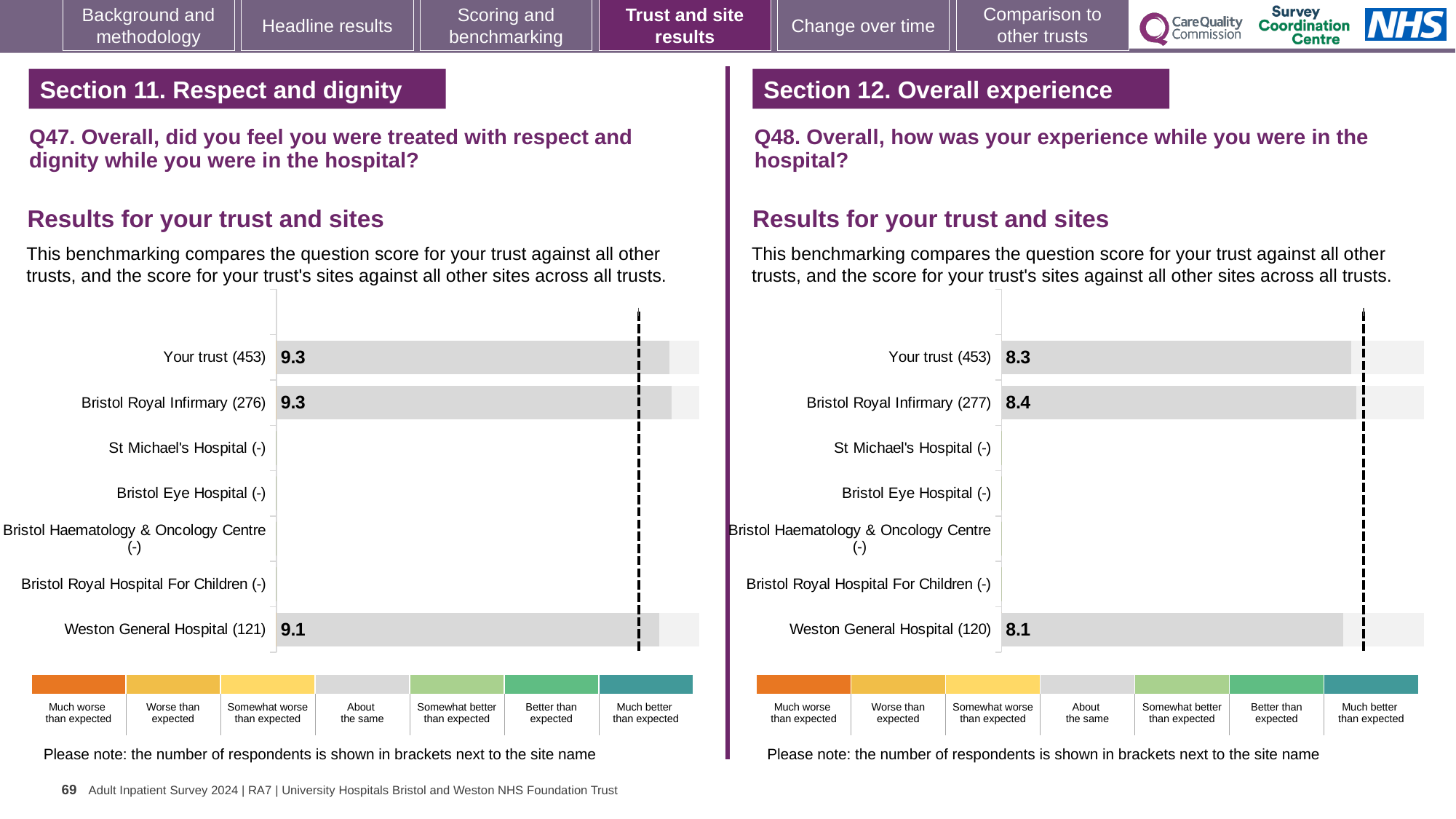
In the Q48 chart on the right, which is larger: the score for Your trust or the score for Weston General Hospital? Your trust In the Q48 chart on the right, what is the score for Weston General Hospital? 8.1 In the Q48 chart on the right, what is the score for Bristol Royal Infirmary? 8.4 What kind of chart is used for the Q47 results on the left? Bar chart In the Q48 chart on the right, which site or trust row has the highest score? Bristol Royal Infirmary In the Q47 chart on the left, what is the score for Weston General Hospital? 9.1 In the Q48 chart on the right, which site or trust row has the lowest score? Weston General Hospital In the Q48 chart on the right, what is the difference between the score for Bristol Royal Infirmary and the score for Weston General Hospital? 0.3 In the Q47 chart on the left, how many respondents are shown in brackets for Bristol Royal Infirmary? 276 How many site or trust rows are listed on the Q47 chart on the left? 7 In the Q47 chart on the left, what is the score for Your trust? 9.3 In the Q47 chart on the left, what is the difference between the score for Your trust and the score for Weston General Hospital? 0.2